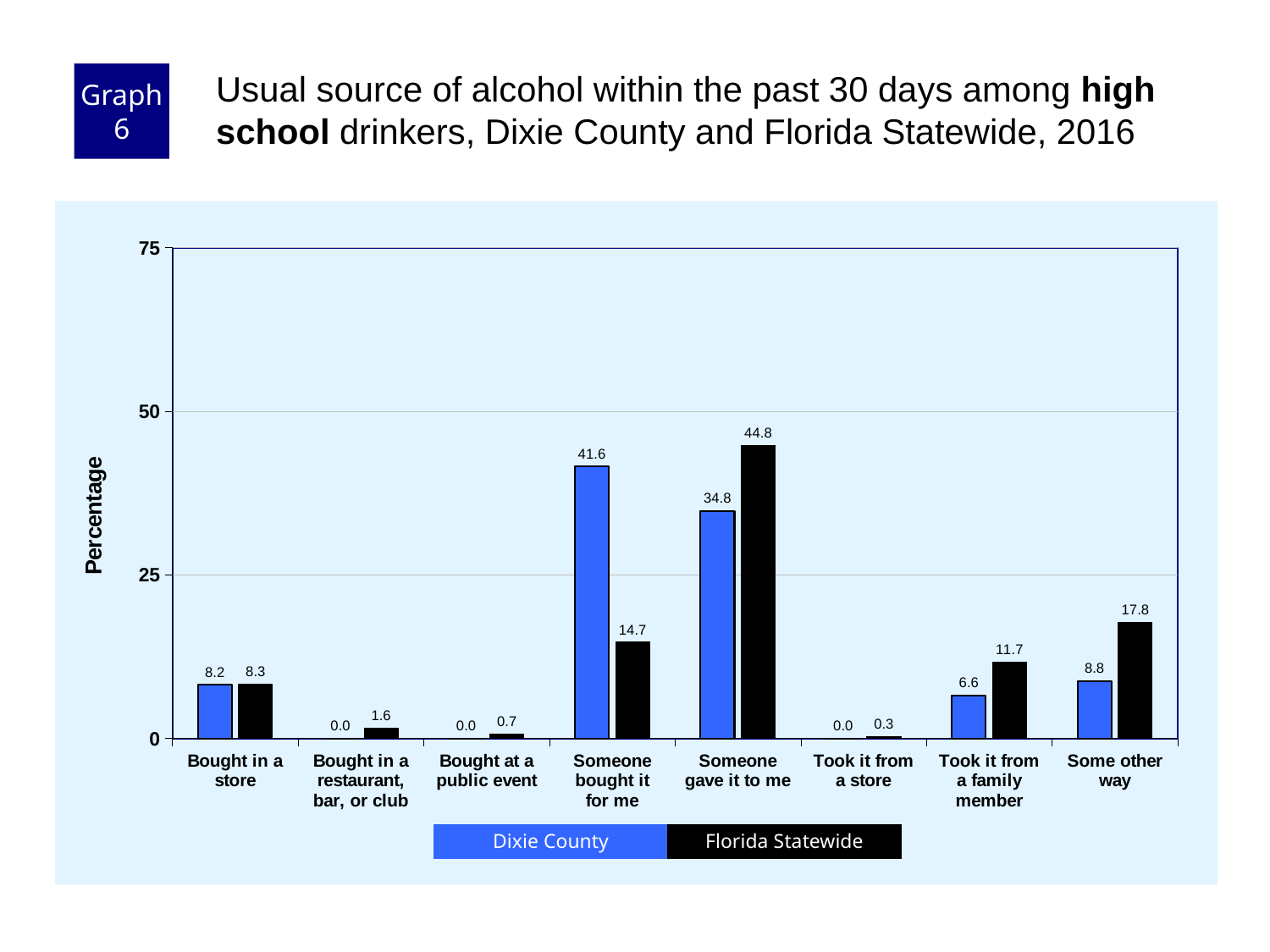
What is the Dixie County value for "Someone bought it for me"? 41.6 What kind of chart is shown on the slide? Bar chart Which is larger for "Someone gave it to me": Dixie County or Florida Statewide? Florida Statewide How many series does the legend list? 2 What is the Florida Statewide value for "Someone gave it to me"? 44.8 Which category has the highest Dixie County value? Someone bought it for me Is the Dixie County value for "Someone bought it for me" greater or less than 25? greater What is the difference between the Florida Statewide and Dixie County values for "Some other way"? 9.0 What is the difference between the Dixie County and Florida Statewide values for "Someone bought it for me"? 26.9 What is the Florida Statewide value for "Took it from a family member"? 11.7 How many categories are shown on the x axis? 8 Which category has the highest Florida Statewide value? Someone gave it to me